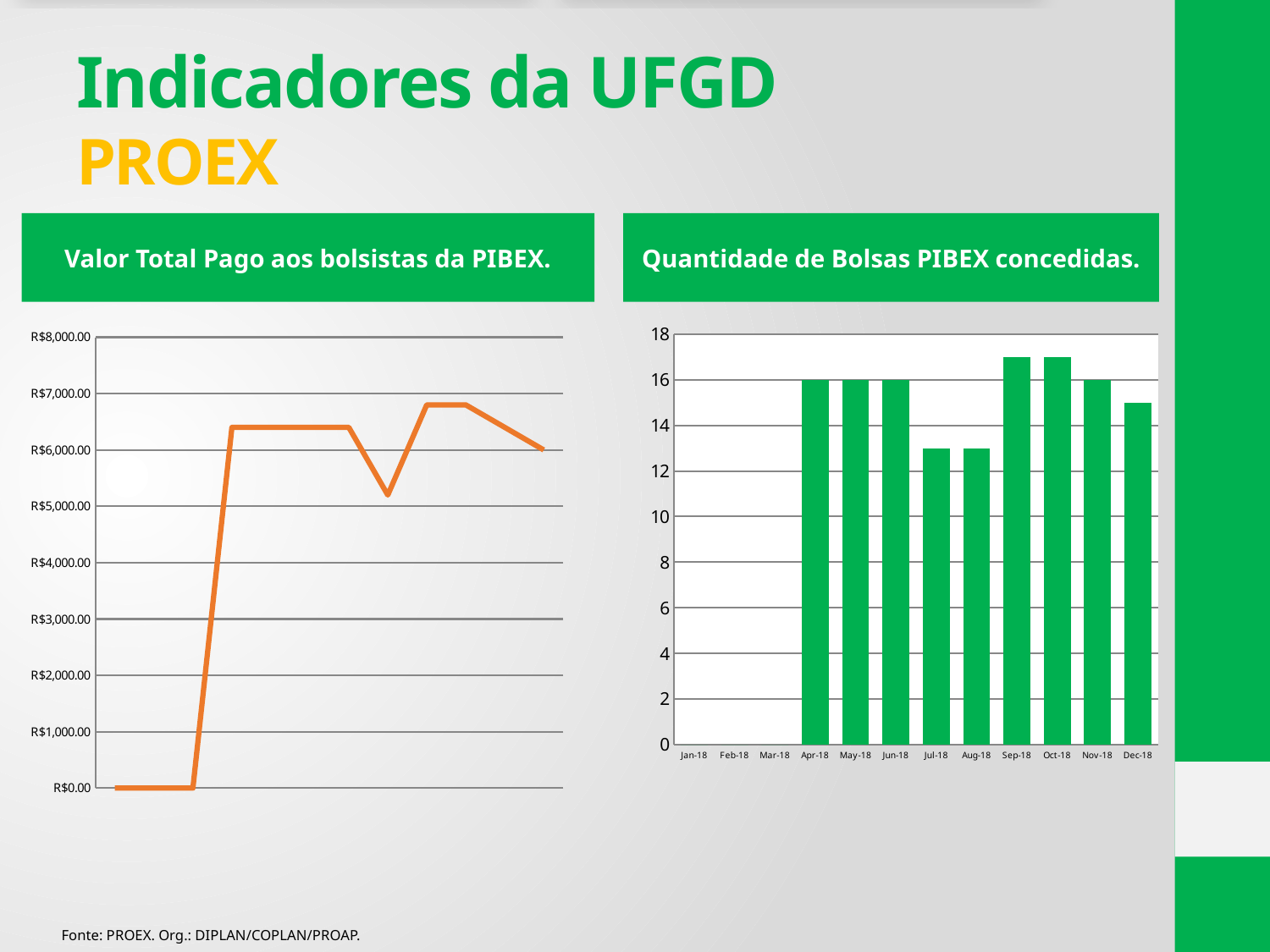
In the chart "Quantidade de Bolsas PIBEX concedidas.", is the value for Sep-18 greater or less than 16? greater What is the highest value shown on the y axis of the chart "Valor Total Pago aos bolsistas da PIBEX."? R$8,000.00 In the chart "Quantidade de Bolsas PIBEX concedidas.", is the value for Jul-18 greater or less than 14? less In the chart "Quantidade de Bolsas PIBEX concedidas.", is the value for Dec-18 greater or less than 16? less In the chart "Quantidade de Bolsas PIBEX concedidas.", what is the value for Feb-18? 0 In the chart "Quantidade de Bolsas PIBEX concedidas.", what is the value for Apr-18? 16 How many months are shown on the x axis of the chart "Quantidade de Bolsas PIBEX concedidas."? 12 In the chart "Quantidade de Bolsas PIBEX concedidas.", which is larger, the value for Jun-18 or the value for Dec-18? Jun-18 In the chart "Quantidade de Bolsas PIBEX concedidas.", which is larger, the value for Aug-18 or the value for Oct-18? Oct-18 What kind of chart is the chart titled "Quantidade de Bolsas PIBEX concedidas."? bar chart What kind of chart is the chart titled "Valor Total Pago aos bolsistas da PIBEX."? line chart In the chart "Quantidade de Bolsas PIBEX concedidas.", what is the value for Nov-18? 16